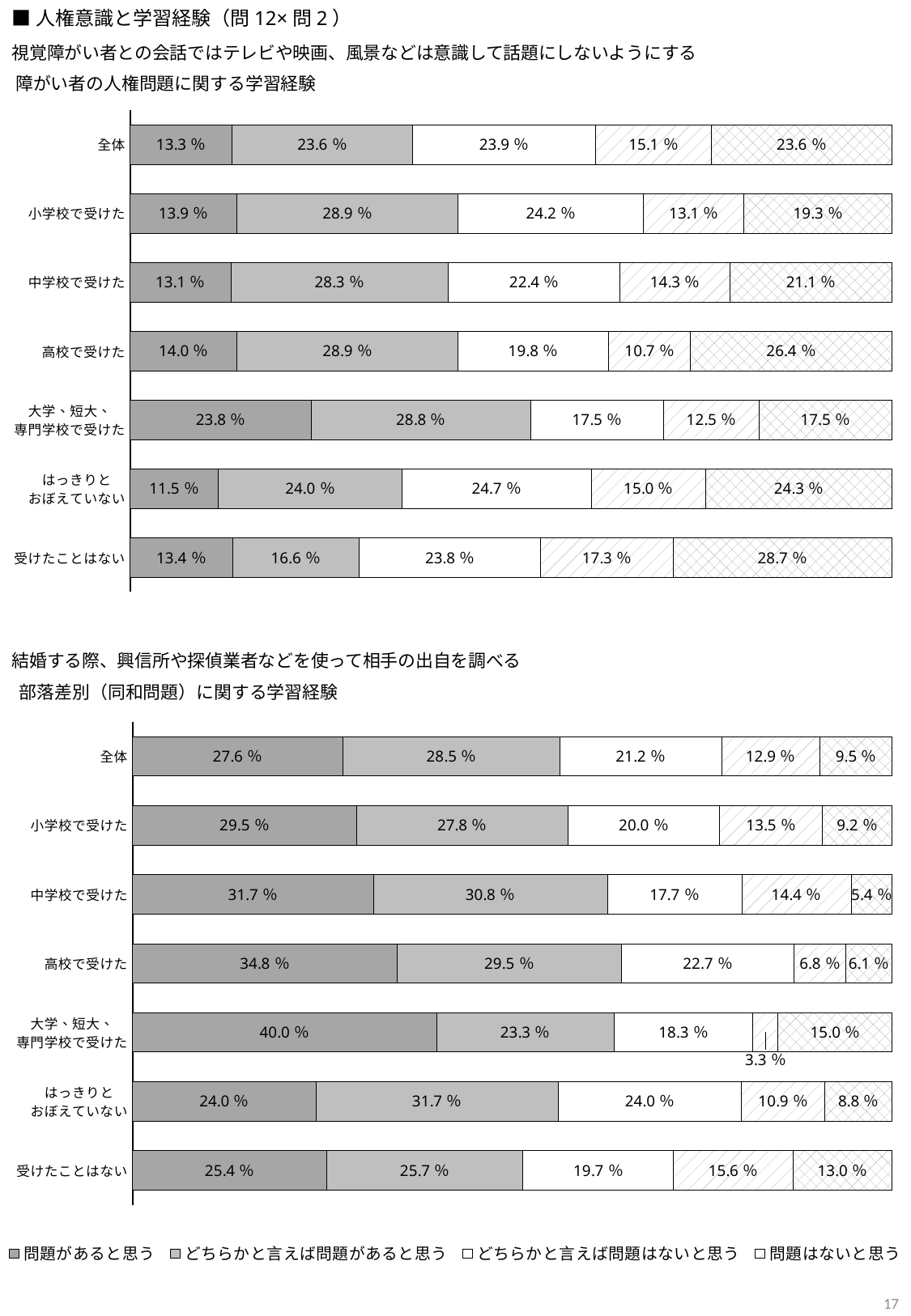
In the top chart (障がい者の人権問題に関する学習経験), which category has the lowest value for 問題があると思う? はっきりとおぼえていない How many series does the legend at the bottom of the slide list? 4 In the bottom chart (部落差別（同和問題）に関する学習経験), which category has the highest value for 問題があると思う? 大学、短大、専門学校で受けた What is the title of the bottom chart on the slide? 部落差別（同和問題）に関する学習経験 In the top chart (障がい者の人権問題に関する学習経験), which has the larger value for どちらかと言えば問題があると思う: 高校で受けた or 受けたことはない? 高校で受けた In the bottom chart (部落差別（同和問題）に関する学習経験), what is the value of 問題があると思う for 大学、短大、専門学校で受けた? 40.0 % In the top chart (障がい者の人権問題に関する学習経験), what is the value of どちらかと言えば問題はないと思う for 受けたことはない? 23.8 % What kind of chart is the top chart (障がい者の人権問題に関する学習経験)? Stacked horizontal bar chart In the top chart (障がい者の人権問題に関する学習経験), what is the difference between the 問題があると思う values for 大学、短大、専門学校で受けた and 全体? 10.5 % In the bottom chart (部落差別（同和問題）に関する学習経験), what is the value of the last (rightmost) segment for 中学校で受けた? 5.4 % In the top chart (障がい者の人権問題に関する学習経験), what is the value of 問題があると思う for 全体? 13.3 % How many categories are shown on the y axis of the bottom chart (部落差別（同和問題）に関する学習経験)? 7